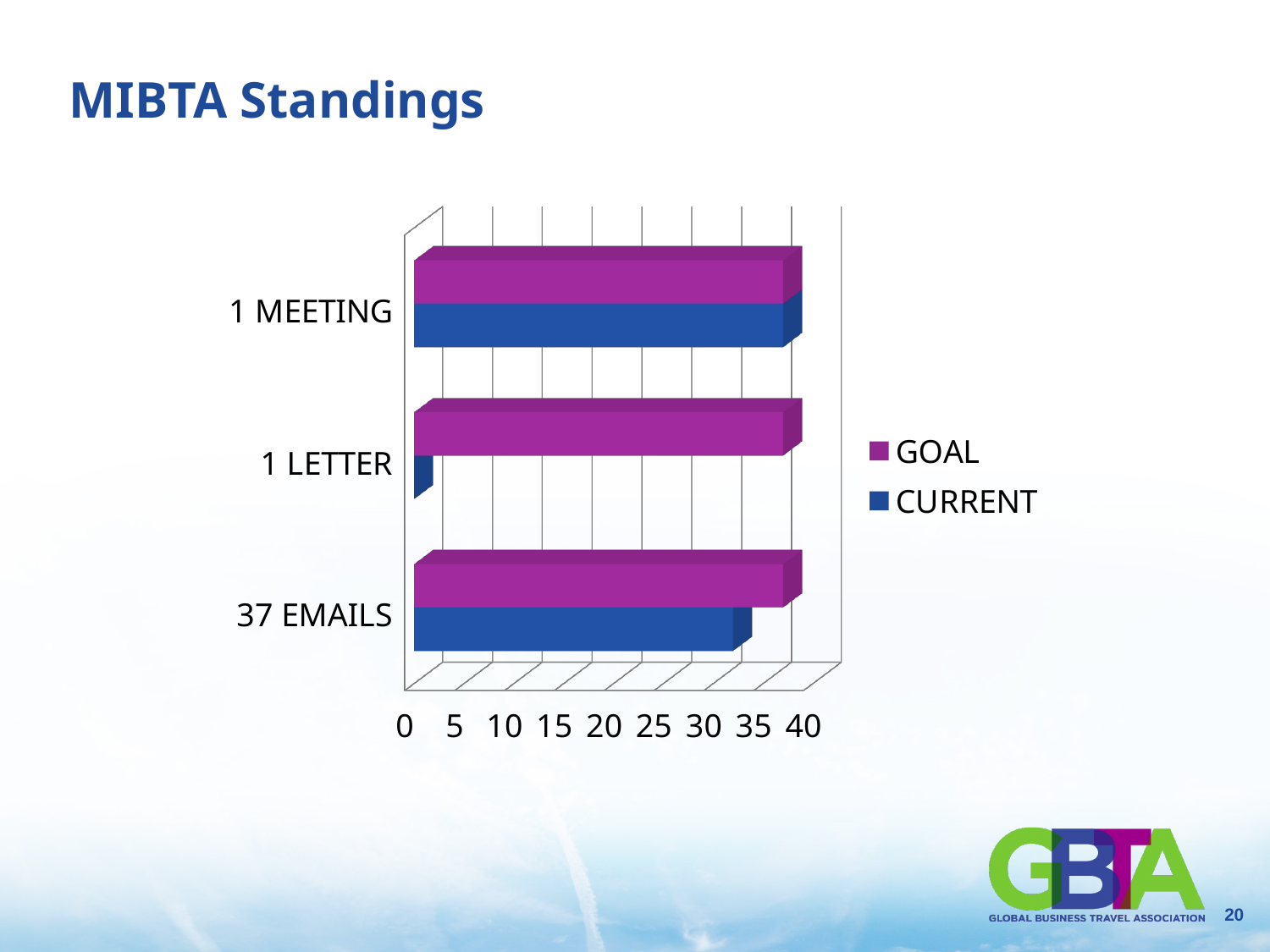
Is the GOAL value for 1 LETTER greater or less than 35? greater Is the CURRENT value for 37 EMAILS greater or less than 30? greater How many categories are shown on the chart? 3 Is the CURRENT value for 1 MEETING greater or less than 35? greater What is the title of the slide containing the chart? MIBTA Standings For 37 EMAILS, which is larger, the GOAL value or the CURRENT value? GOAL What kind of chart is shown on the slide? bar chart For 1 LETTER, which is larger, the GOAL value or the CURRENT value? GOAL Which series is shown in purple in the legend? GOAL How many series does the legend list? 2 Which category has the lowest CURRENT value? 1 LETTER